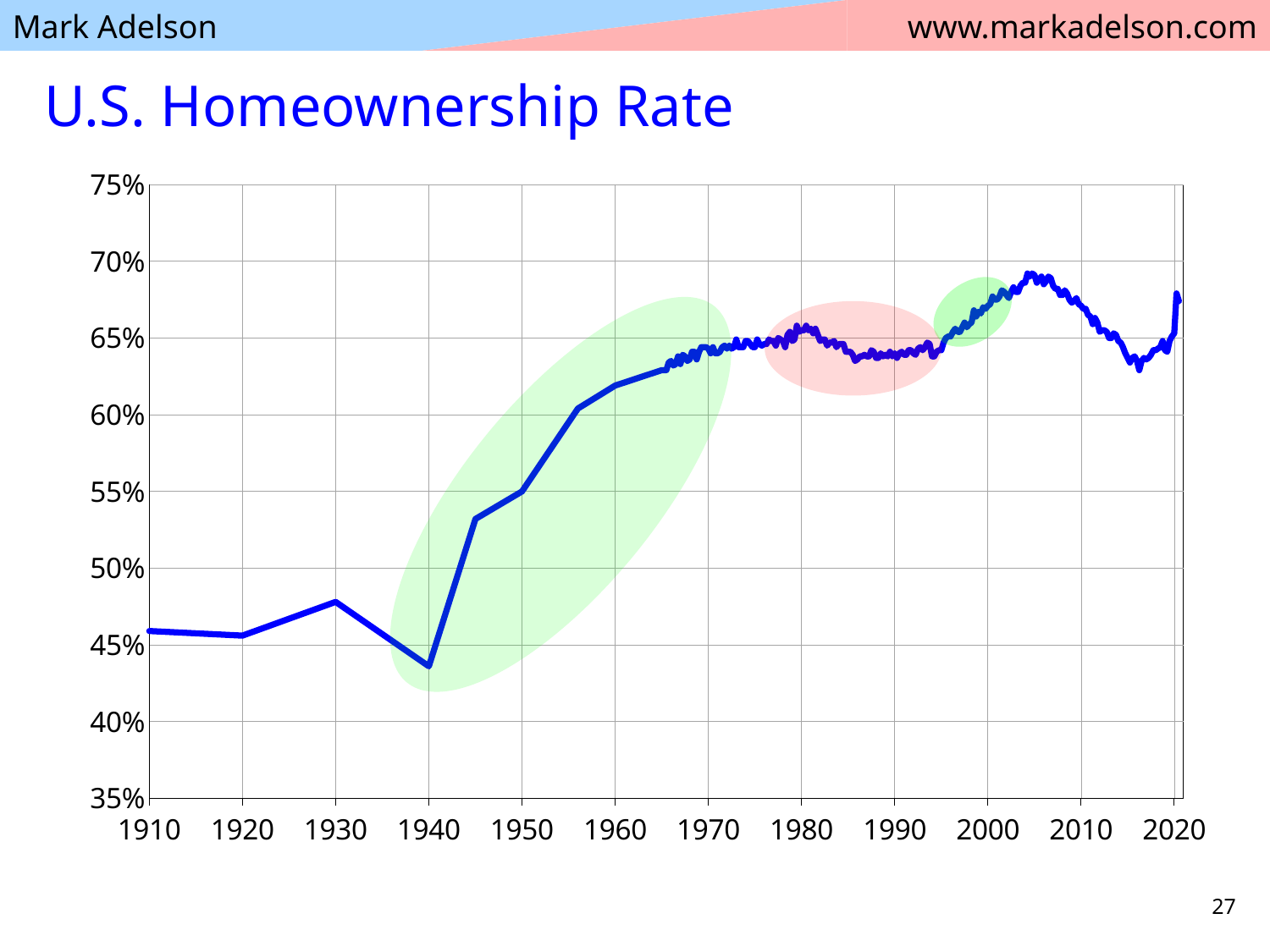
Does the homeownership rate rise or fall between 2005 and 2016? fall Is the homeownership rate in 1960 greater or less than 60%? greater Around which year does the homeownership rate reach its highest point on the chart? 2005 Is the homeownership rate in 1930 greater or less than 50%? less Is the homeownership rate in 1945 greater or less than 50%? greater What kind of chart is shown on the slide? Line chart What is the title of the chart? U.S. Homeownership Rate Which year has the higher homeownership rate, 1930 or 1940? 1930 Around which year does the homeownership rate reach its lowest point on the chart? 1940 Does the homeownership rate rise or fall between 1940 and 1960? rise